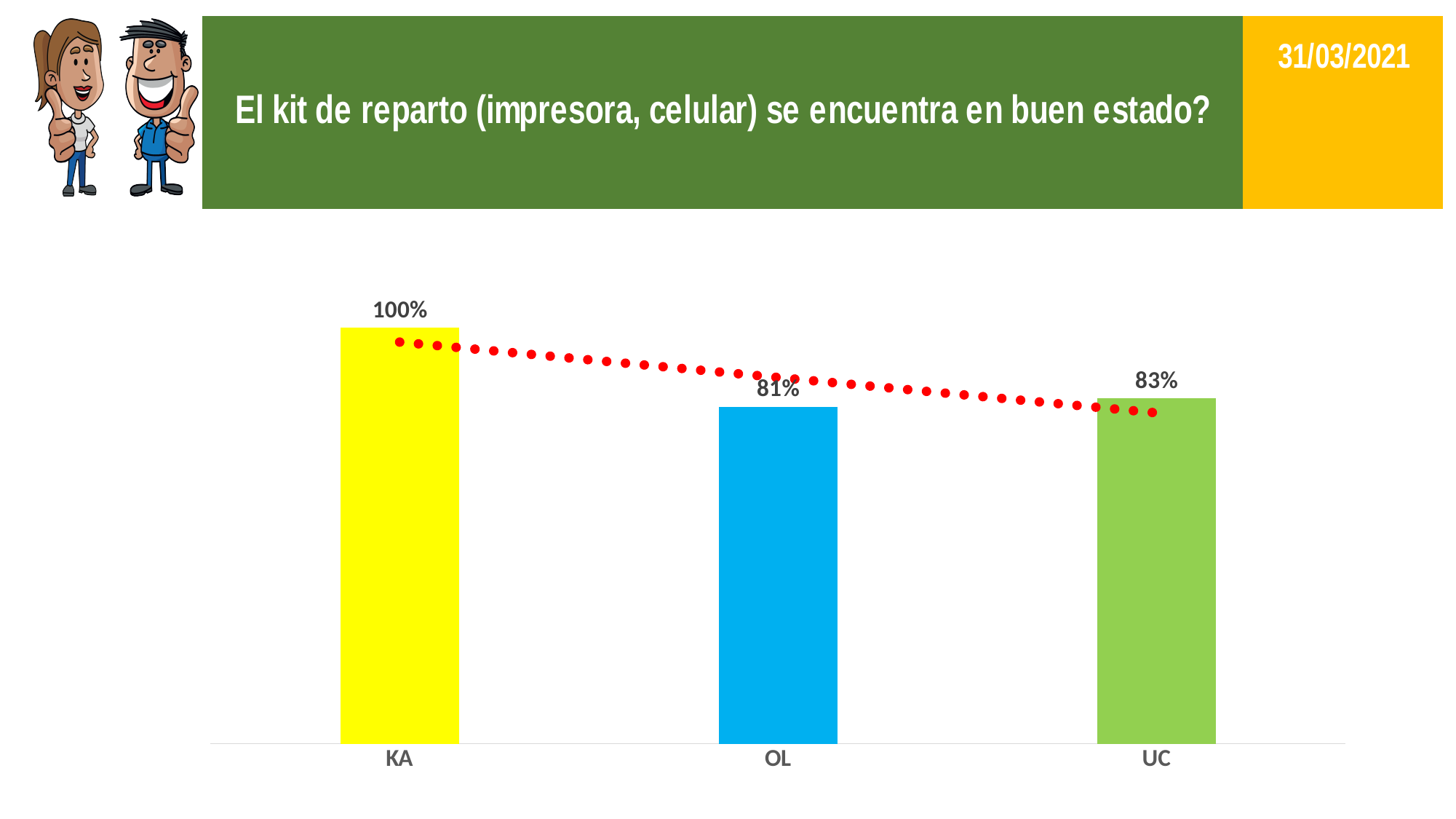
Which category has the highest value? KA What is the difference between the values for UC and OL? 2% What colour is the bar for OL? blue What is the value for OL? 81% What is the difference between the values for KA and OL? 19% What is the value for UC? 83% What is the value for KA? 100% What question is shown in the title banner above the chart? El kit de reparto (impresora, celular) se encuentra en buen estado? Which category has the lowest value? OL What kind of chart is shown on the slide? bar chart How many categories are shown on the x axis? 3 Which is larger, the value for KA or the value for UC? KA